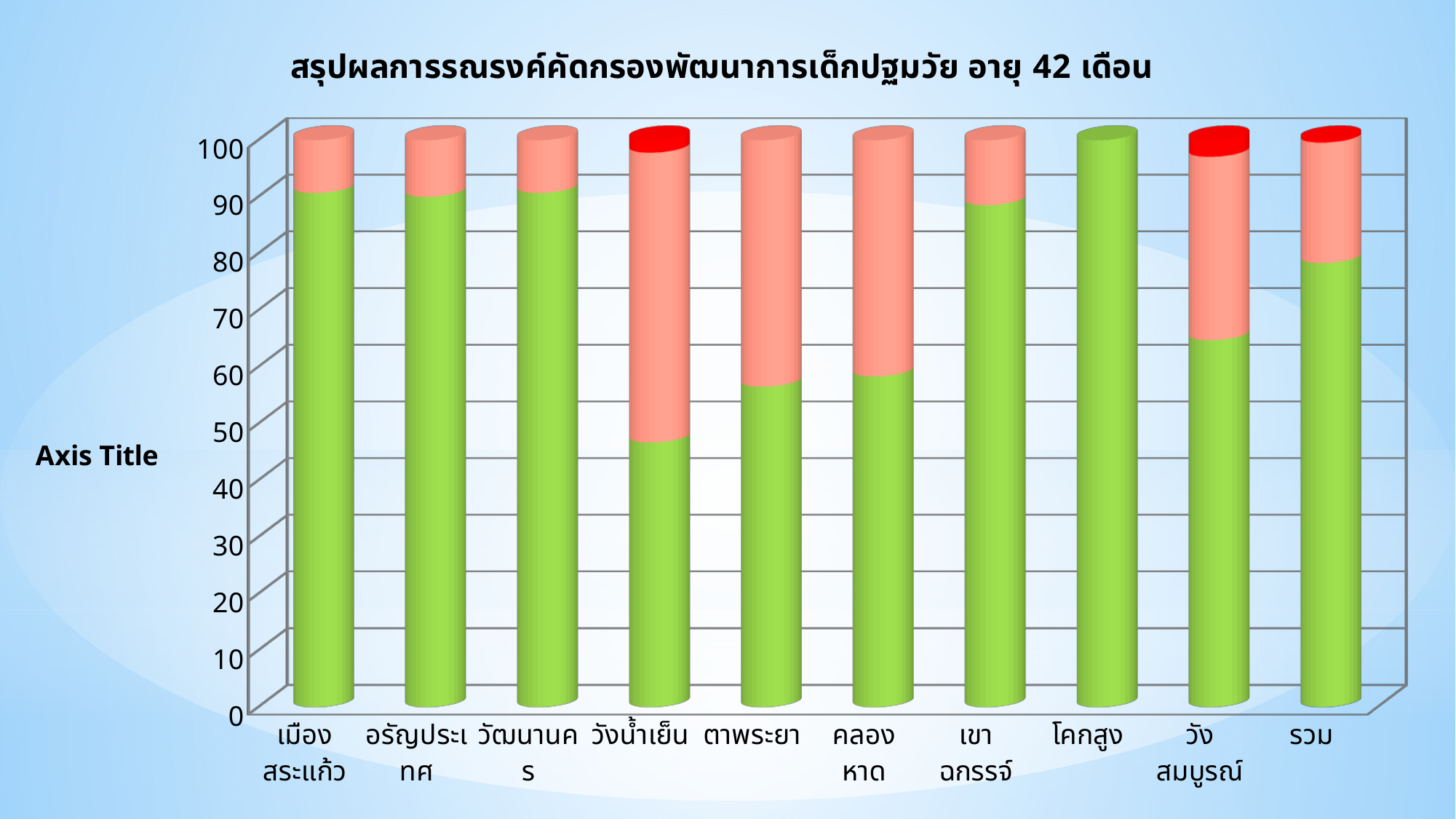
Which category has the tallest green segment? โคกสูง What text is shown as the vertical axis title? Axis Title What kind of chart is shown on the slide? stacked bar chart Is the green segment for เขาฉกรรจ์ greater or less than 80? greater Which category has the shortest green segment? วังน้ำเย็น Is the green segment for รวม greater or less than 70? greater Which has the larger green segment, ตาพระยา or วังสมบูรณ์? วังสมบูรณ์ What is the title of the chart? สรุปผลการรณรงค์คัดกรองพัฒนาการเด็กปฐมวัย อายุ 42 เดือน Is the green segment for วังน้ำเย็น greater or less than 40? greater How many categories are shown along the x axis? 10